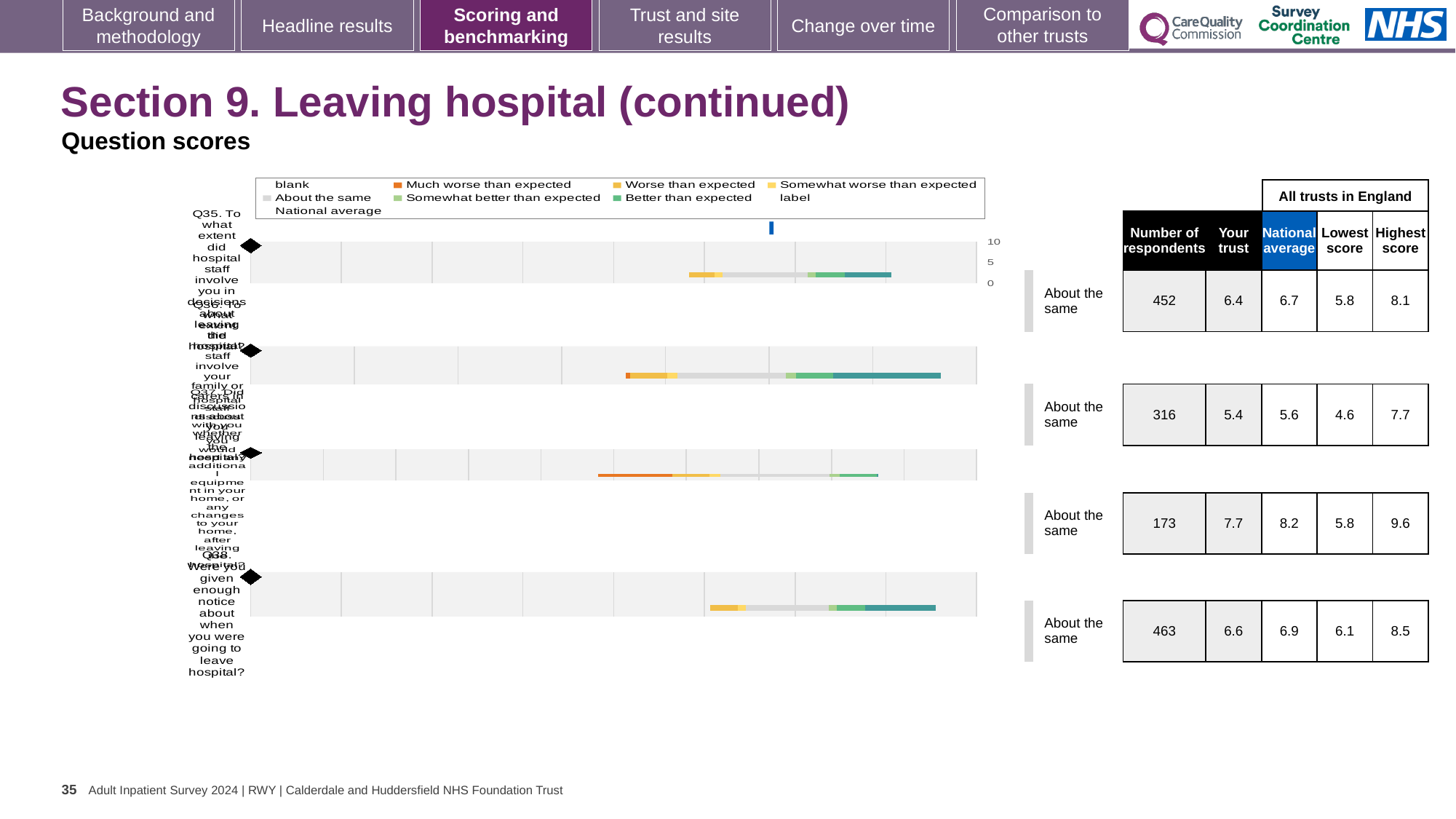
For Q35, how many respondents are there? 452 For Q38, what is the highest score among all trusts in England? 8.5 What benchmark category is shown for Q35? About the same In the legend, which colour represents 'Much worse than expected'? Orange Which of the four questions has the highest number of respondents? Q38 For Q35, what is the national average score? 6.7 For Q38 (given enough notice about leaving hospital), what is the 'Your trust' score? 6.6 How many question charts are shown on the slide? 4 For Q35, which is larger: the 'Your trust' score or the national average? National average For Q38, what is the difference between the highest score and the lowest score among all trusts in England? 2.4 What kind of chart is used for the question scores on this slide? bar chart For Q35 (involving you in decisions about leaving hospital), what is the 'Your trust' score? 6.4